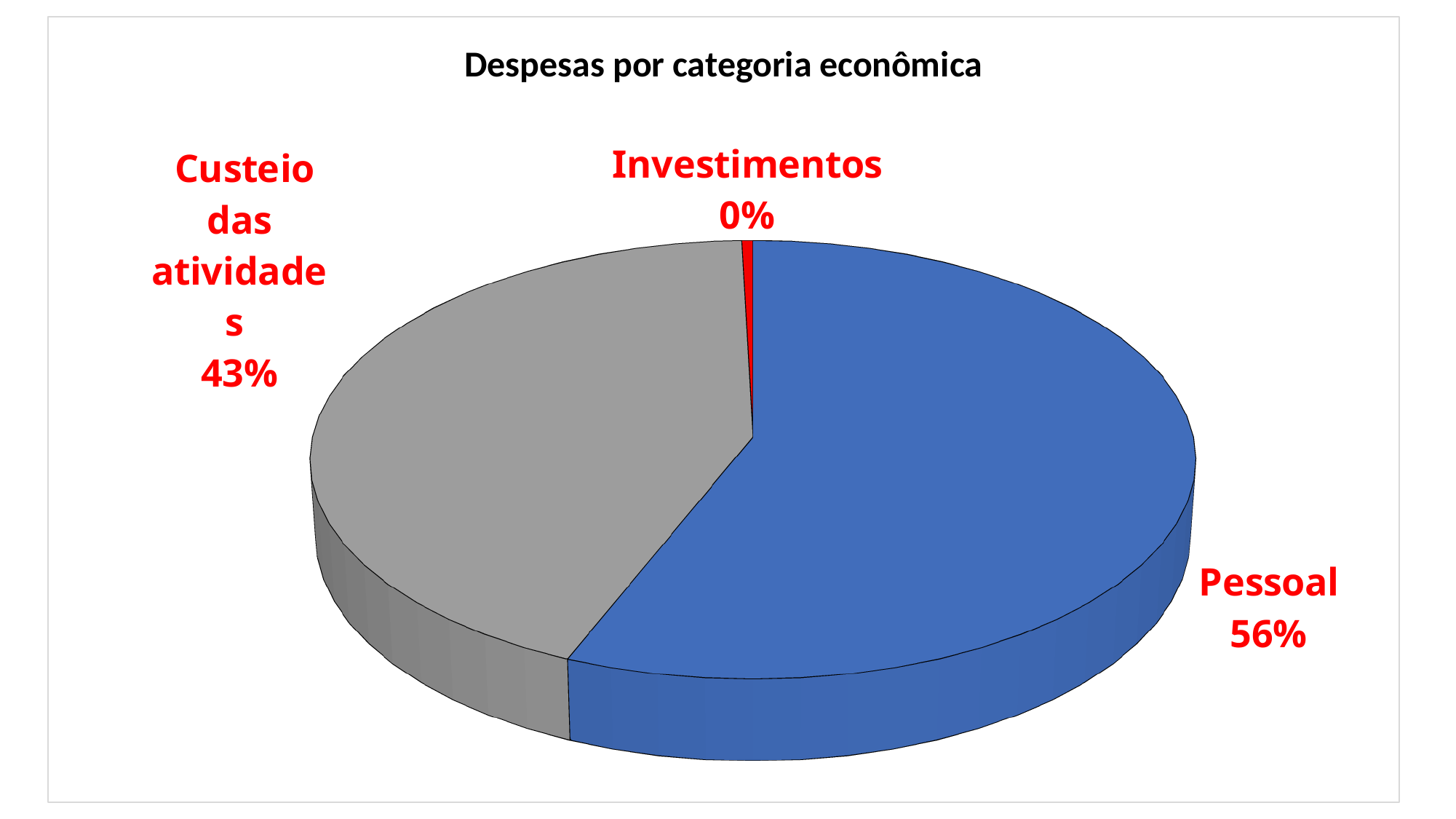
What share of the pie does Custeio das atividades represent? 43% Which category has the largest share of the pie? Pessoal What colour is the Pessoal slice? Blue What is the title of the chart? Despesas por categoria econômica How many categories are shown in the pie chart? 3 Which category has the smallest share of the pie? Investimentos What kind of chart is shown on the slide? Pie chart What share of the pie does Investimentos represent? 0% Is the share for Custeio das atividades greater or less than 50%? less What share of the pie does Pessoal represent? 56% Which is larger, the share for Pessoal or the share for Custeio das atividades? Pessoal What is the difference in percentage points between Pessoal and Custeio das atividades? 13